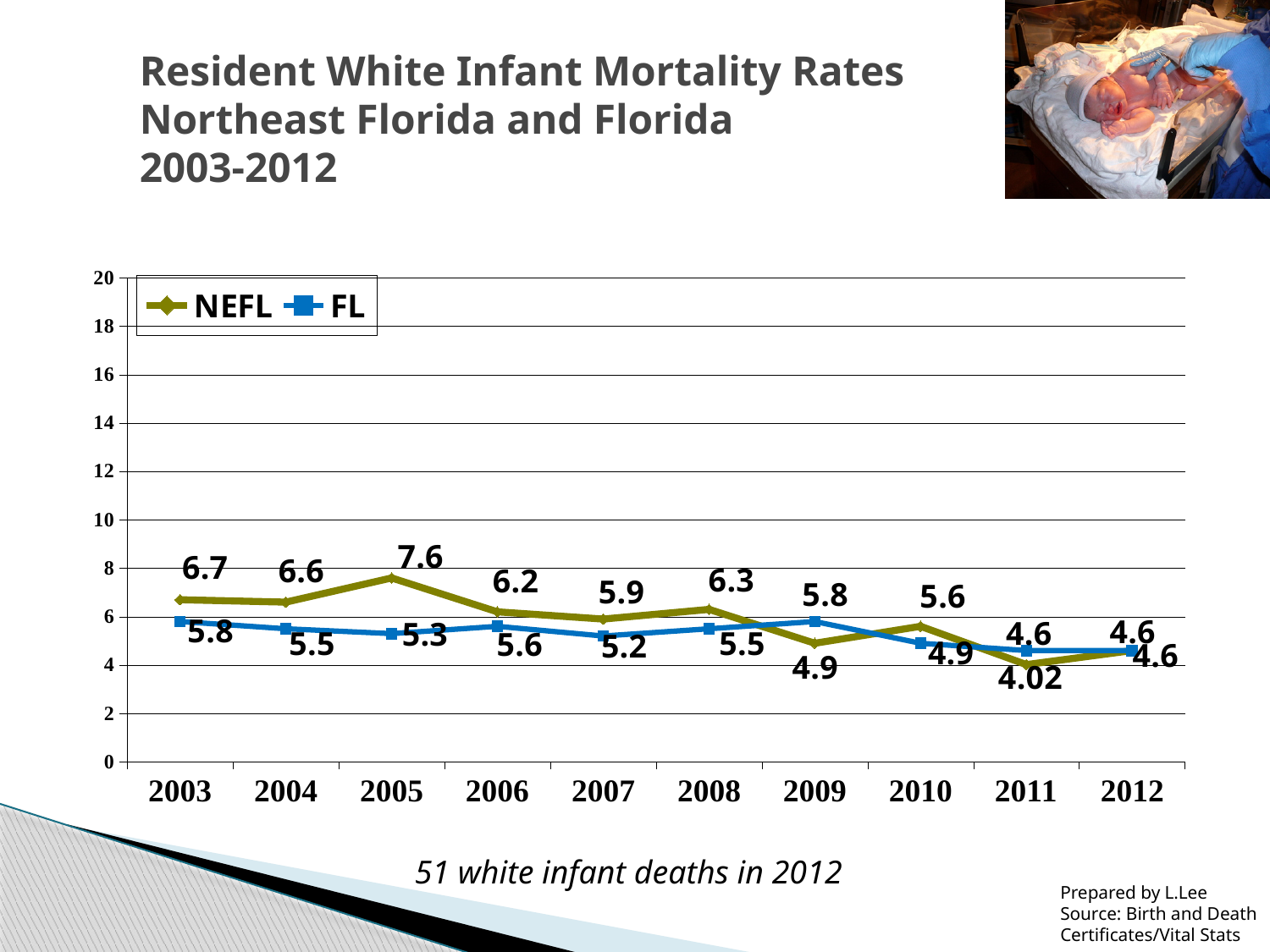
What is the NEFL infant mortality rate in 2005? 7.6 What is the FL infant mortality rate in 2009? 5.8 In which year is the NEFL rate lowest? 2011 Is the NEFL value for 2005 greater or less than 6? greater In which year is the NEFL rate highest? 2005 How many years are shown on the x axis? 10 What is the NEFL value in 2011? 4.02 What is the difference between the NEFL and FL rates in 2003? 0.9 Which series has the higher value in 2010, NEFL or FL? NEFL What kind of chart is shown on the slide? Line chart How many series does the legend list? 2 Does the FL rate generally rise or fall from 2003 to 2012? Fall